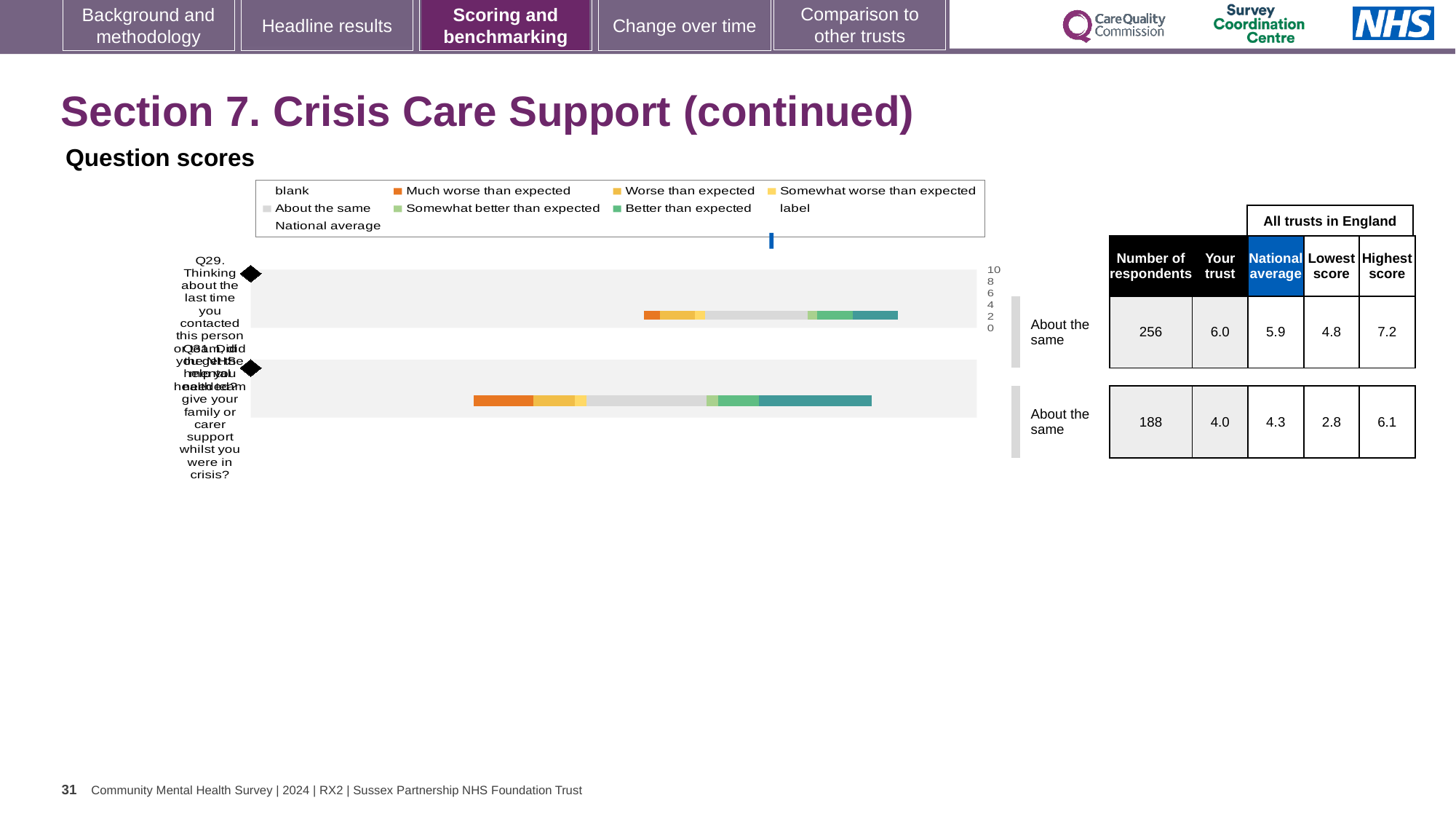
What benchmark category is shown next to the bar for Q31? About the same What is the difference between the highest score and the lowest score for Q31? 3.3 How many questions (bars) are plotted in the question scores chart? 2 Which question has the higher 'Your trust' score, Q29 or Q31? Q29 What is the highest score among all trusts in England for Q31? 6.1 What is the national average score shown for Q29? 5.9 What colour does the legend use for 'Much worse than expected'? orange What kind of chart is used to show the question scores on this slide? bar chart How many respondents are listed for Q31? 188 According to the table beside the chart, what is the 'Your trust' score for Q29? 6.0 What is the lowest score among all trusts in England for Q29? 4.8 For Q29, is the trust's score higher or lower than the national average? higher